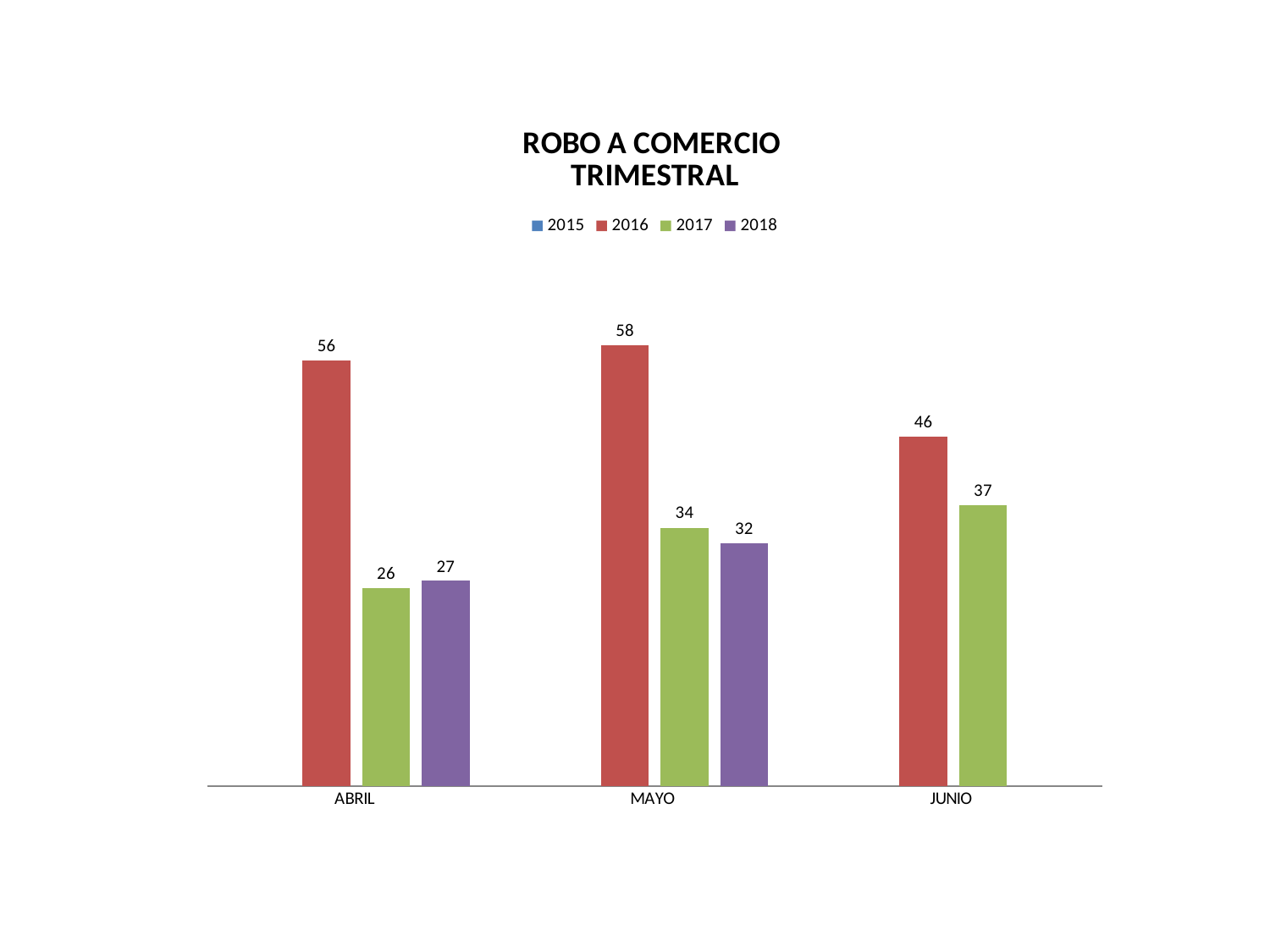
What is the title of the chart? ROBO A COMERCIO TRIMESTRAL What is the value for 2017 in MAYO? 34 What is the value for 2017 in JUNIO? 37 What is the value for 2016 in ABRIL? 56 In which month is the 2016 value highest? MAYO In which month is the 2017 value lowest? ABRIL What kind of chart is this? Bar chart How many series does the legend list? 4 What is the value for 2018 in MAYO? 32 How many months are shown on the x axis? 3 Which is larger in MAYO, the 2017 value or the 2018 value? 2017 What is the difference between the 2016 and 2017 values in ABRIL? 30